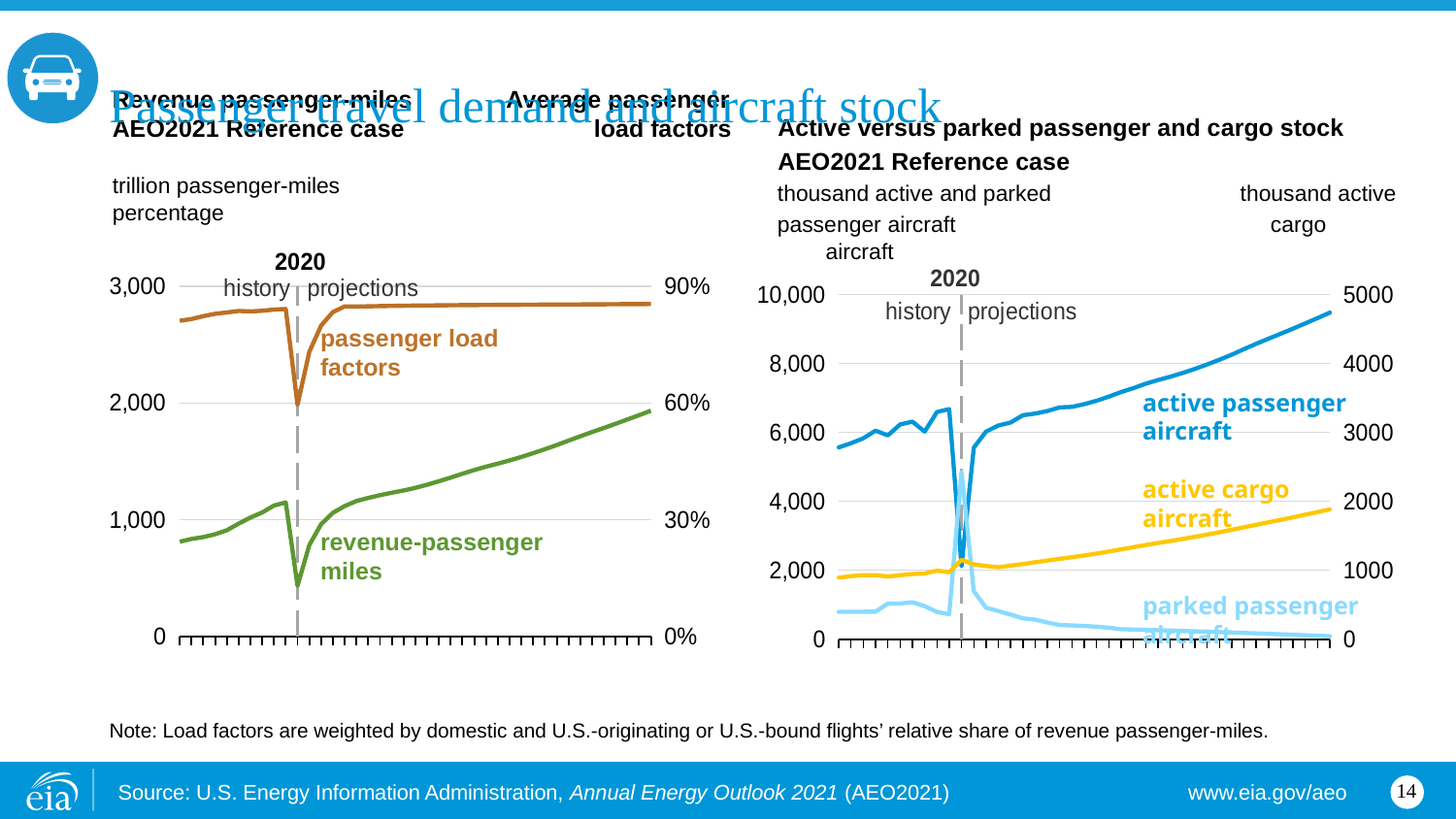
What kind of chart is the left chart showing revenue passenger-miles and load factors? line chart How many series are plotted on the left chart showing revenue passenger-miles and load factors? 2 On the right chart, which is larger at the end of the projection period: 'active passenger aircraft' or 'parked passenger aircraft'? active passenger aircraft On the left chart, is the value for 'revenue-passenger miles' at the end of the projection period greater or less than 2,000? less What kind of chart is the 'Active versus parked passenger and cargo stock' chart on the right? line chart What year does the dashed vertical line separating history from projections mark on both charts? 2020 How many series are plotted on the right chart, 'Active versus parked passenger and cargo stock'? 3 On the left chart, does the 'revenue-passenger miles' series rise or fall over the projection period? rise On the right chart, does the 'parked passenger aircraft' series rise or fall over the projection period? fall On the right chart, does the 'active passenger aircraft' series rise or fall over the projection period? rise On the left chart, is the 'passenger load factors' value at the end of the projection period greater or less than 60%? greater On the right chart, is the value for 'active passenger aircraft' at the end of the projection period greater or less than 8,000? greater